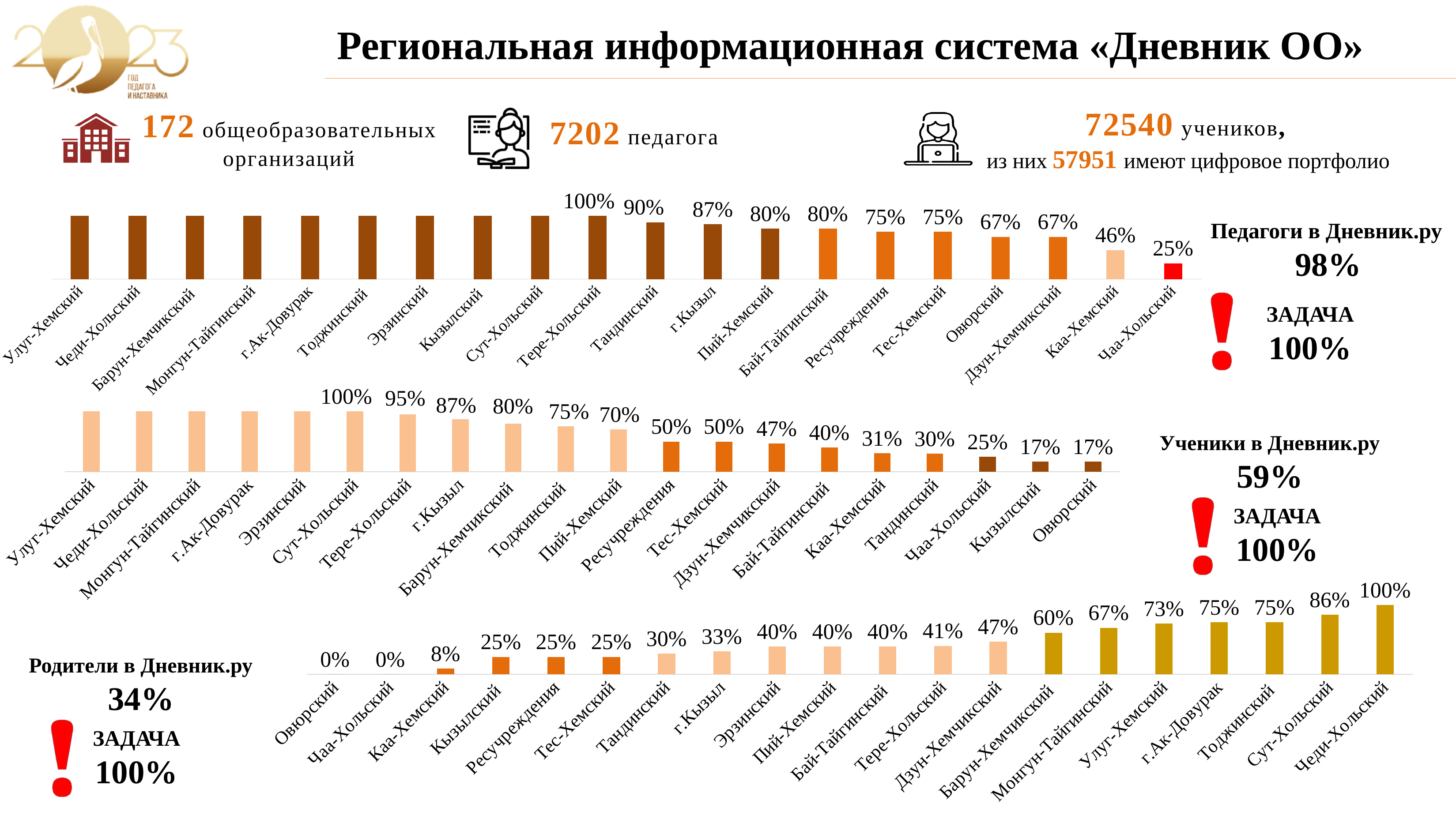
In the 'Ученики в Дневник.ру' chart, what is the value for Тере-Хольский? 95% In the 'Родители в Дневник.ру' chart, which category has the highest value? Чеди-Хольский In the 'Родители в Дневник.ру' chart, do the values rise or fall from left to right along the x axis? rise What kind of chart is the 'Ученики в Дневник.ру' chart? bar chart In the 'Ученики в Дневник.ру' chart, which is larger, the value for Барун-Хемчикский or the value for Дзун-Хемчикский? Барун-Хемчикский How many categories are shown in the 'Родители в Дневник.ру' chart? 20 In the 'Ученики в Дневник.ру' chart, what is the difference between the values for Пий-Хемский and Тандинский? 40% In the 'Педагоги в Дневник.ру' chart, what is the value for Тандинский? 90% In the 'Родители в Дневник.ру' chart, what is the value for Сут-Хольский? 86% In the 'Педагоги в Дневник.ру' chart, which category has the lowest value? Чаа-Хольский What overall percentage is shown next to the 'Родители в Дневник.ру' chart? 34% In the 'Педагоги в Дневник.ру' chart, what is the difference between the values for г.Кызыл and Каа-Хемский? 41%